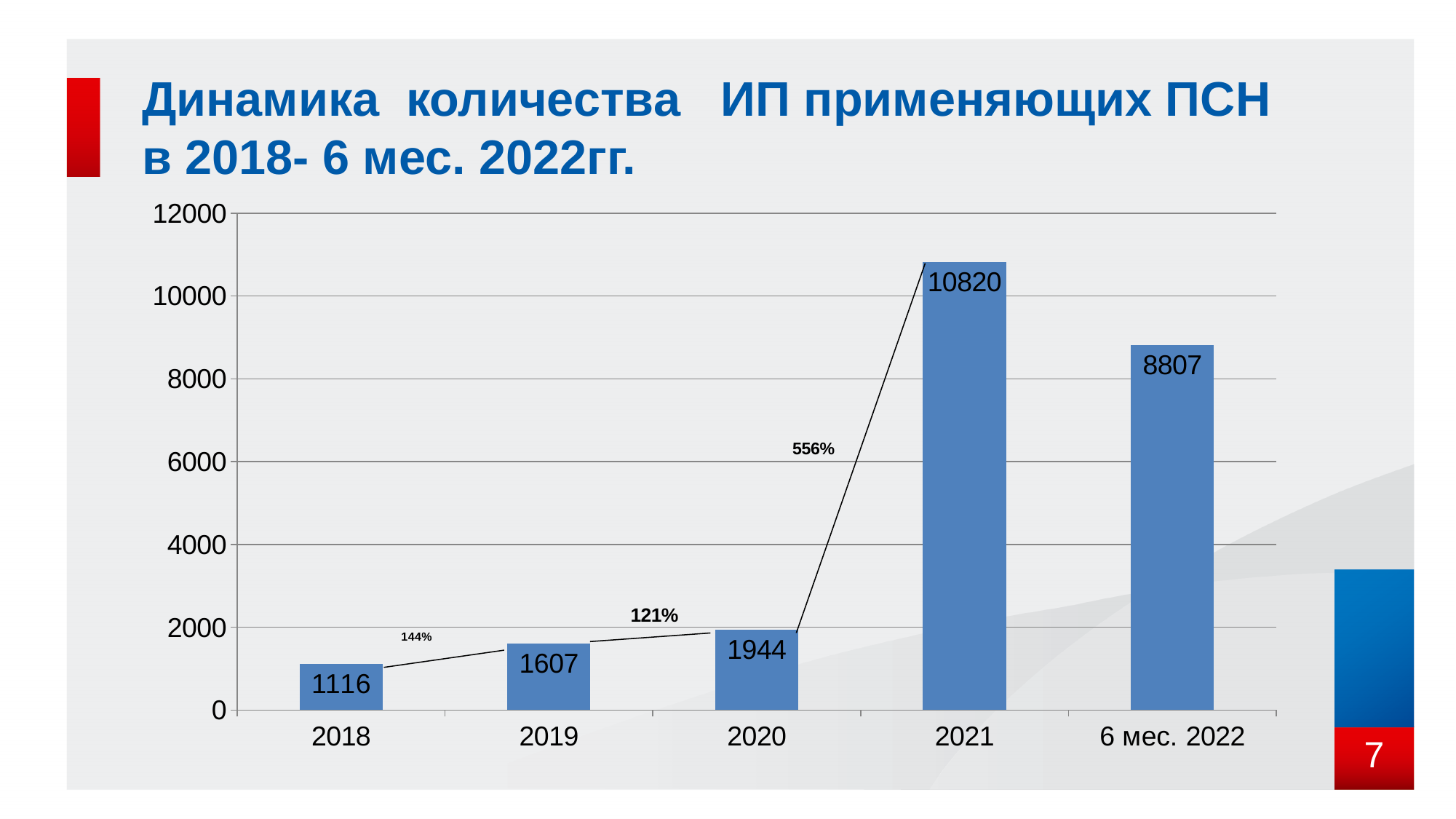
What percentage label is shown between the 2020 and 2021 bars? 556% What is the difference between the values for 2019 and 2018? 491 What is the difference between the values for 2021 and 2020? 8876 What kind of chart is shown on the slide? bar chart Which is larger, the value for 2021 or the value for 6 мес. 2022? 2021 Which category has the highest value? 2021 Which category has the lowest value? 2018 Is the value for 2021 greater or less than 10000? greater How many categories are shown on the x axis? 5 What is the value for 2021? 10820 What is the value for 2018? 1116 What is the value for 6 мес. 2022? 8807